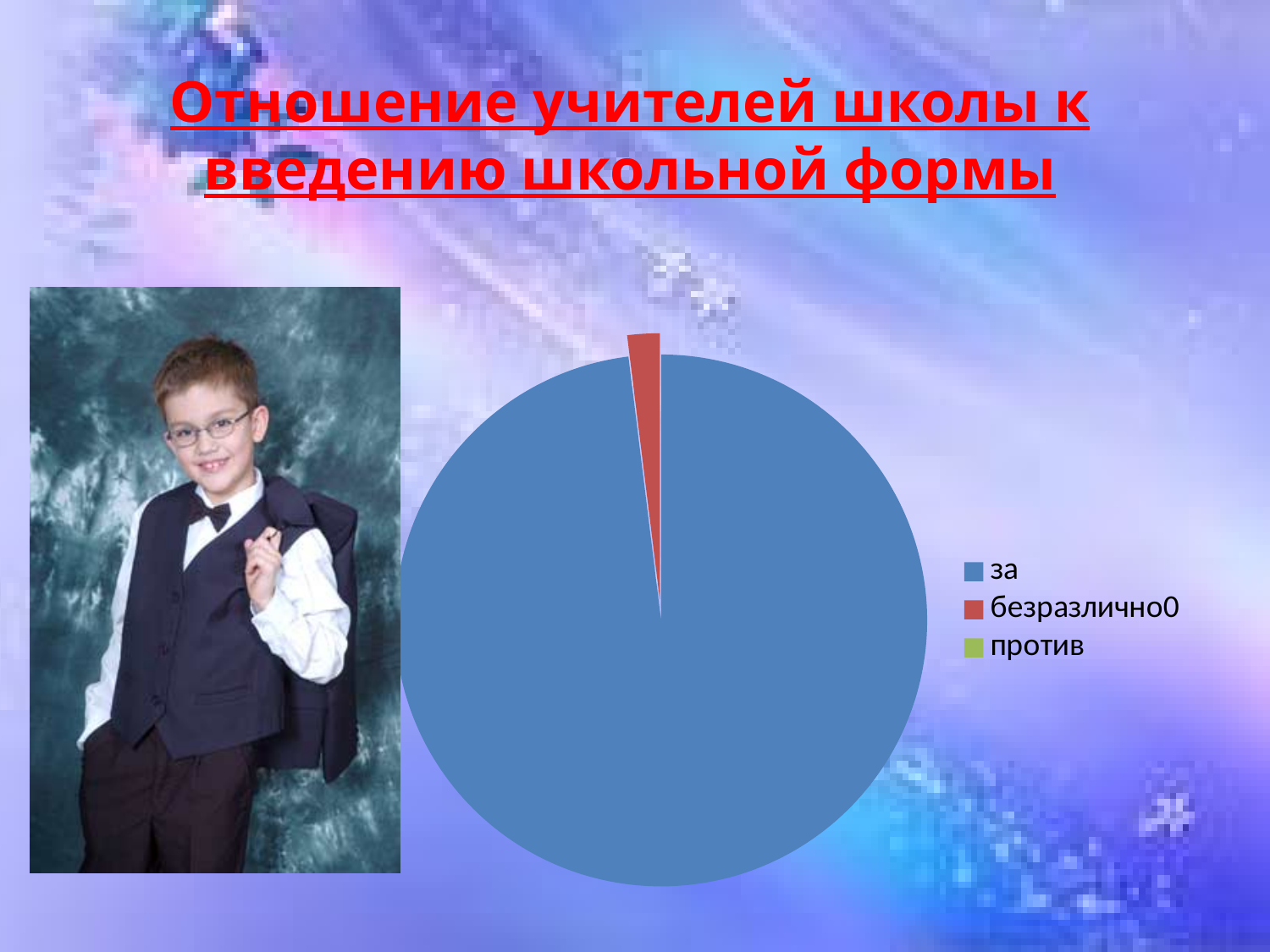
What is the title of the slide with the pie chart? Отношение учителей школы к введению школьной формы Which legend category has no visible slice in the pie chart? против What colour is the slice for за in the pie chart? blue What kind of chart is shown on the slide? pie chart How many categories does the legend of the pie chart list? 3 Which category has the largest slice of the pie chart? за Which is larger in the pie chart, the slice for за or the slice for безразлично0? за